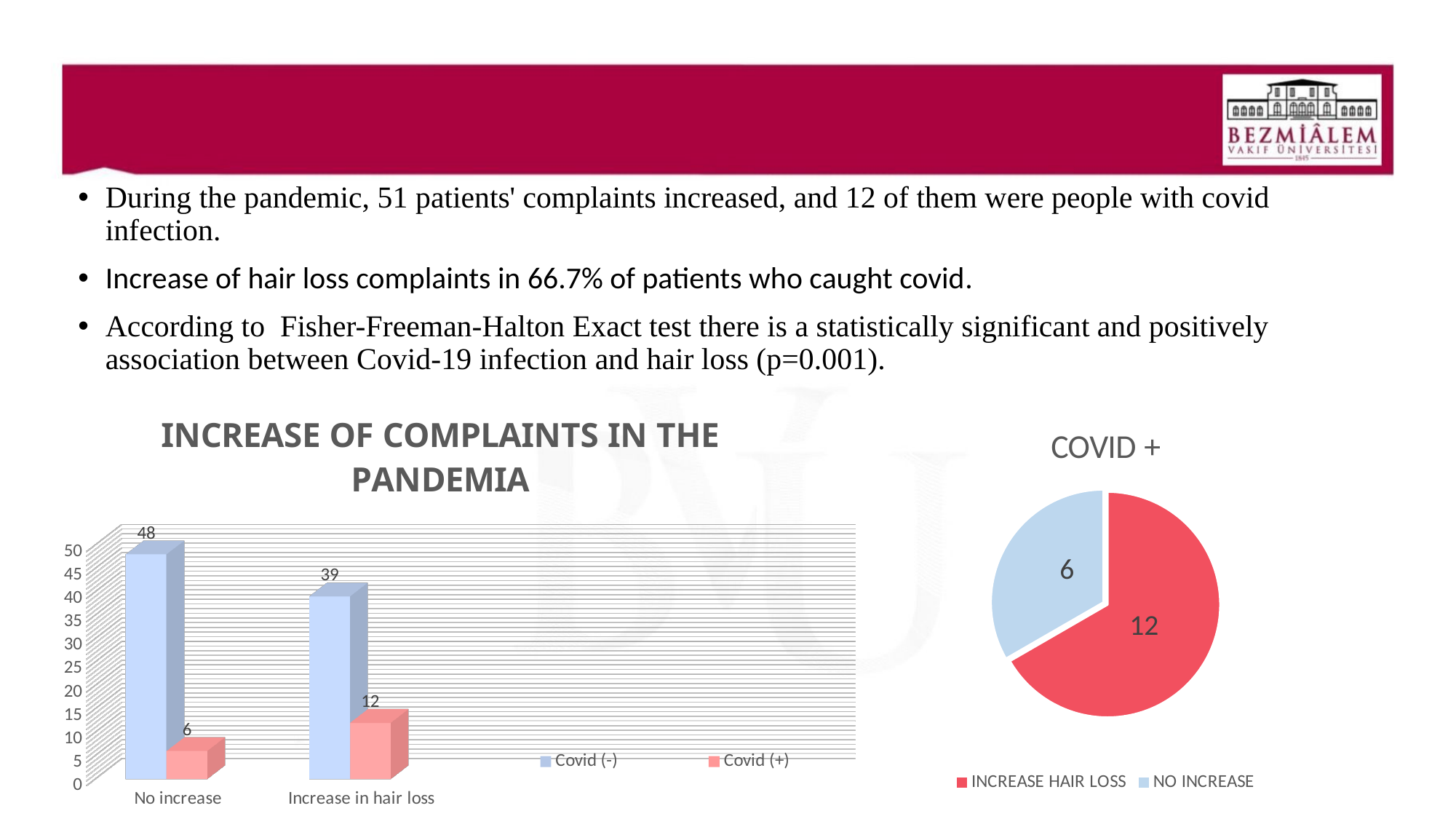
In the 'INCREASE OF COMPLAINTS IN THE PANDEMIA' chart, what is the value for Covid (+) in the 'No increase' category? 6 In the 'INCREASE OF COMPLAINTS IN THE PANDEMIA' chart, what is the value for Covid (+) in the 'Increase in hair loss' category? 12 In the 'COVID +' chart, what is the value for 'INCREASE HAIR LOSS'? 12 In the 'INCREASE OF COMPLAINTS IN THE PANDEMIA' chart, what is the value for Covid (-) in the 'No increase' category? 48 In the 'COVID +' chart, what is the value for 'NO INCREASE'? 6 What kind of chart is the 'INCREASE OF COMPLAINTS IN THE PANDEMIA' chart? Bar chart In the 'INCREASE OF COMPLAINTS IN THE PANDEMIA' chart, how many series does the legend list? 2 In the 'INCREASE OF COMPLAINTS IN THE PANDEMIA' chart, which series has the larger value in the 'Increase in hair loss' category? Covid (-) What kind of chart is the 'COVID +' chart? Pie chart In the 'COVID +' chart, which slice is the largest? INCREASE HAIR LOSS In the 'INCREASE OF COMPLAINTS IN THE PANDEMIA' chart, what is the difference between the Covid (-) values for 'No increase' and 'Increase in hair loss'? 9 In the 'INCREASE OF COMPLAINTS IN THE PANDEMIA' chart, how many categories are shown on the x axis? 2